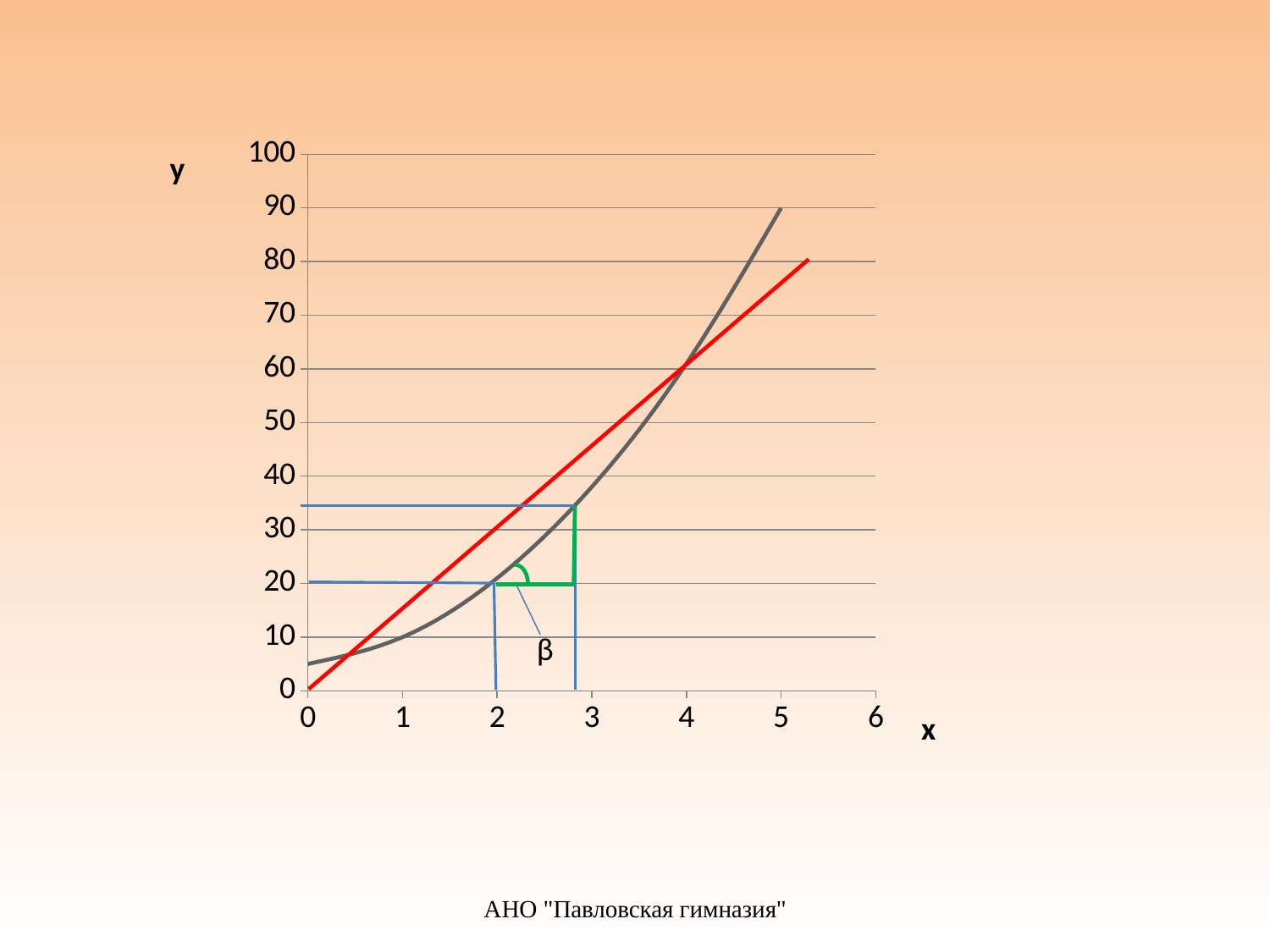
Do the values of the grey curve rise or fall as x increases? rise What Greek letter labels the angle marked in green on the chart? β Do the values of the red line rise or fall as x increases? rise At x = 5, which is higher: the grey curve or the red line? the grey curve What is the highest value shown on the y axis? 100 Is the value of the red line at x = 1 greater or less than 20? less How many lines (curves) are plotted on the chart? 2 Is the value of the grey curve at x = 2 greater or less than 30? less Is the value of the red line at x = 5 greater or less than 80? less What kind of chart is shown on the slide? line chart At x = 2, which is higher: the grey curve or the red line? the red line